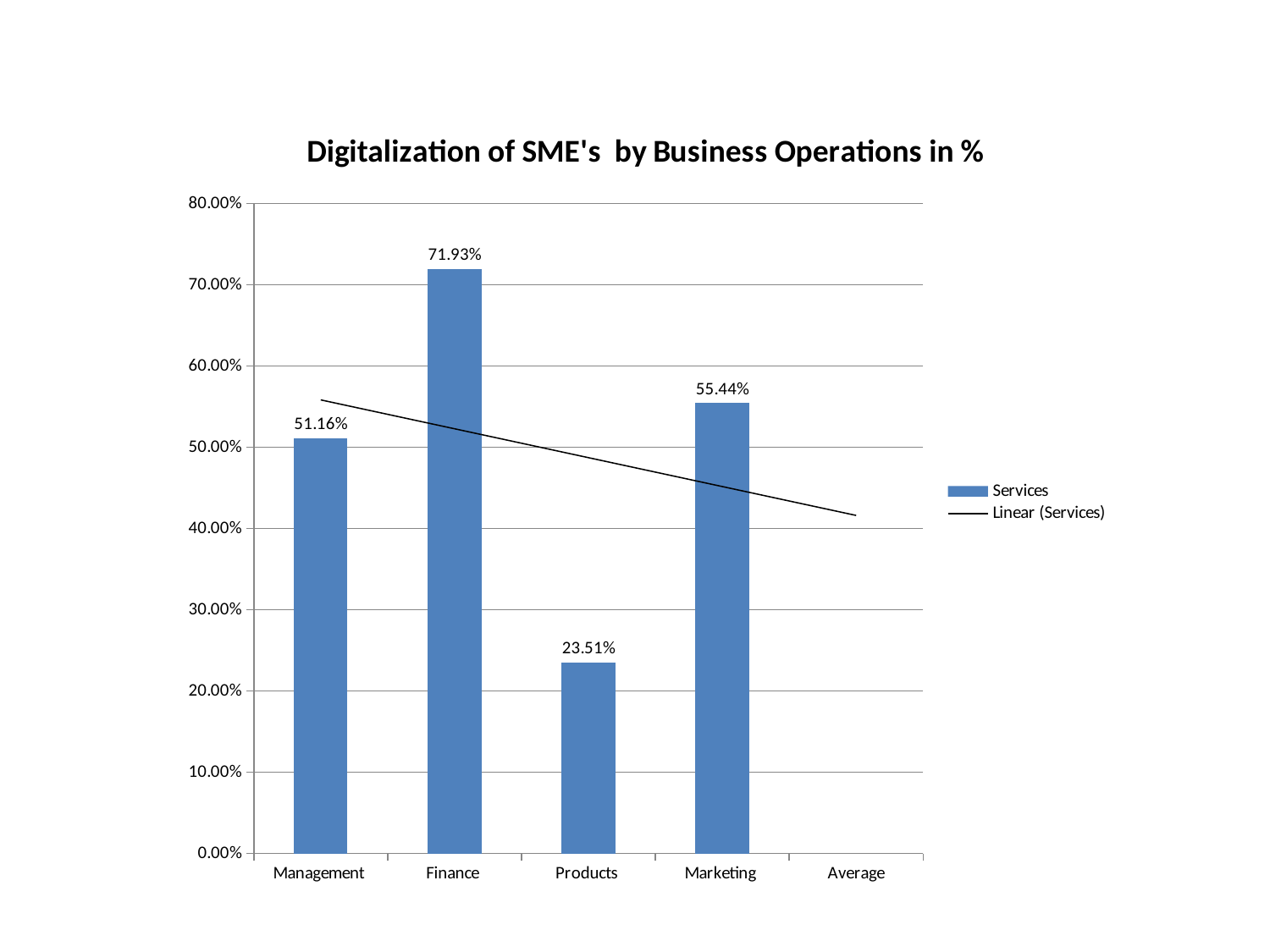
Which category has the highest value? Finance What is the value for Products? 23.51% Which is larger, the value for Marketing or the value for Management? Marketing What is the value for Finance? 71.93% What is the difference between the values for Finance and Management? 20.77% Is the value for Products greater or less than 30.00%? less What is the value for Management? 51.16% What kind of chart is shown on the slide? bar chart How many bars are plotted on the chart? 4 What is the difference between the values for Marketing and Products? 31.93% Does the linear trendline rise or fall from left to right? fall Which category has the lowest value? Products